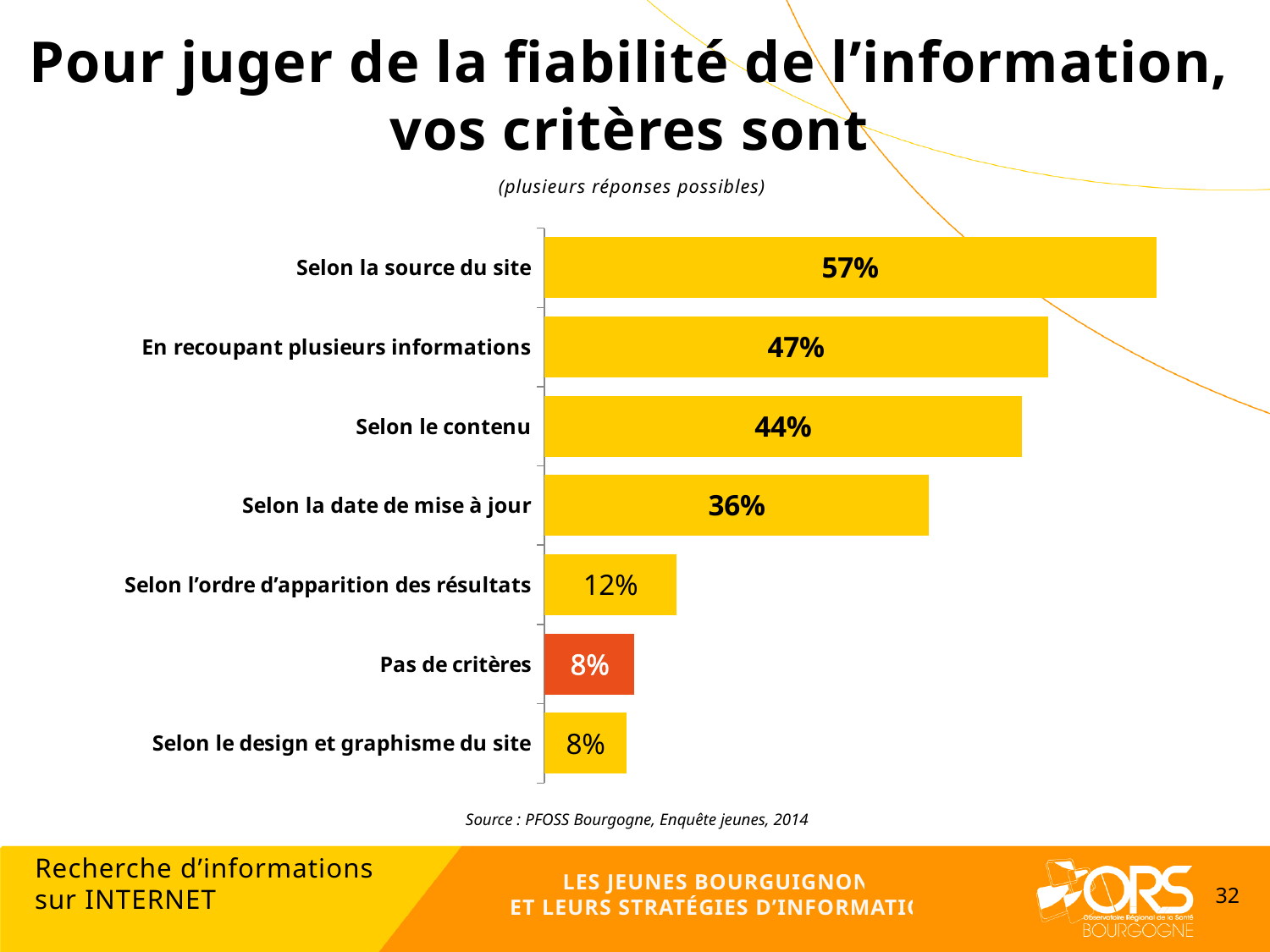
What is the difference between "Selon le contenu" and "Selon la date de mise à jour"? 8% What kind of chart is shown on the slide? Bar chart What is the difference between "Selon la source du site" and "En recoupant plusieurs informations"? 10% Which category has the highest value? Selon la source du site What is the value for "Selon la date de mise à jour"? 36% What is the value for "En recoupant plusieurs informations"? 47% What is the value for "Selon l'ordre d'apparition des résultats"? 12% Which category's bar is coloured differently (orange-red) from the others? Pas de critères What is the value for "Selon la source du site"? 57% How many categories are shown in the chart? 7 What is the value for "Pas de critères"? 8% Which is larger, "Selon le contenu" or "Selon la date de mise à jour"? Selon le contenu